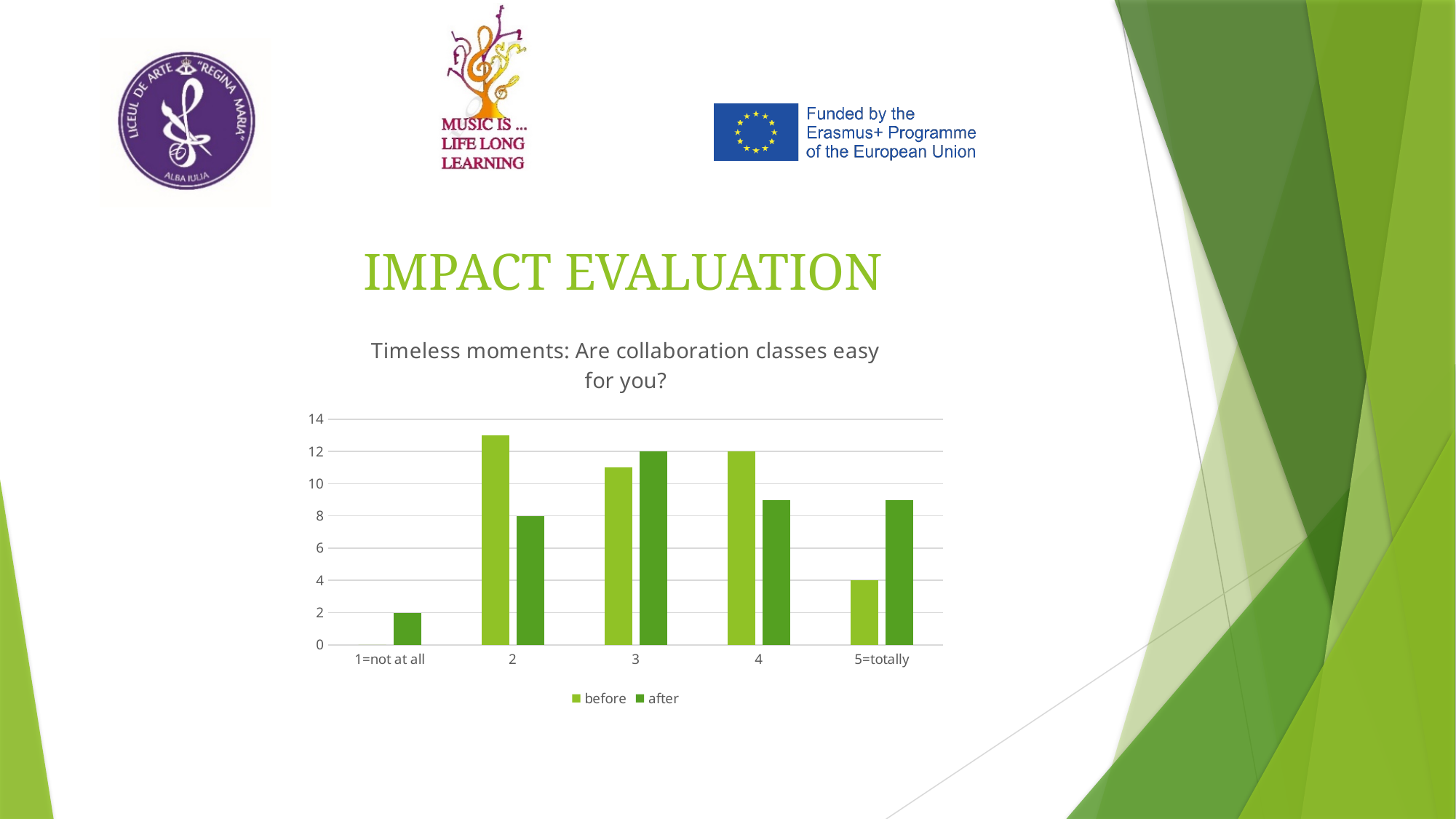
What is the 'before' value for category 4? 12 What is the 'after' value for '1=not at all'? 2 How many series does the legend list? 2 What kind of chart is shown on the slide? bar chart For '5=totally', which is larger, the 'before' value or the 'after' value? after What is the 'after' value for category 3? 12 Is the 'before' value for category 2 greater or less than 12? greater How many categories are shown on the x axis? 5 What is the difference between the 'before' value for category 4 and the 'before' value for '5=totally'? 8 Which category has the highest 'after' value? 3 What is the 'before' value for '5=totally'? 4 What is the 'after' value for category 2? 8